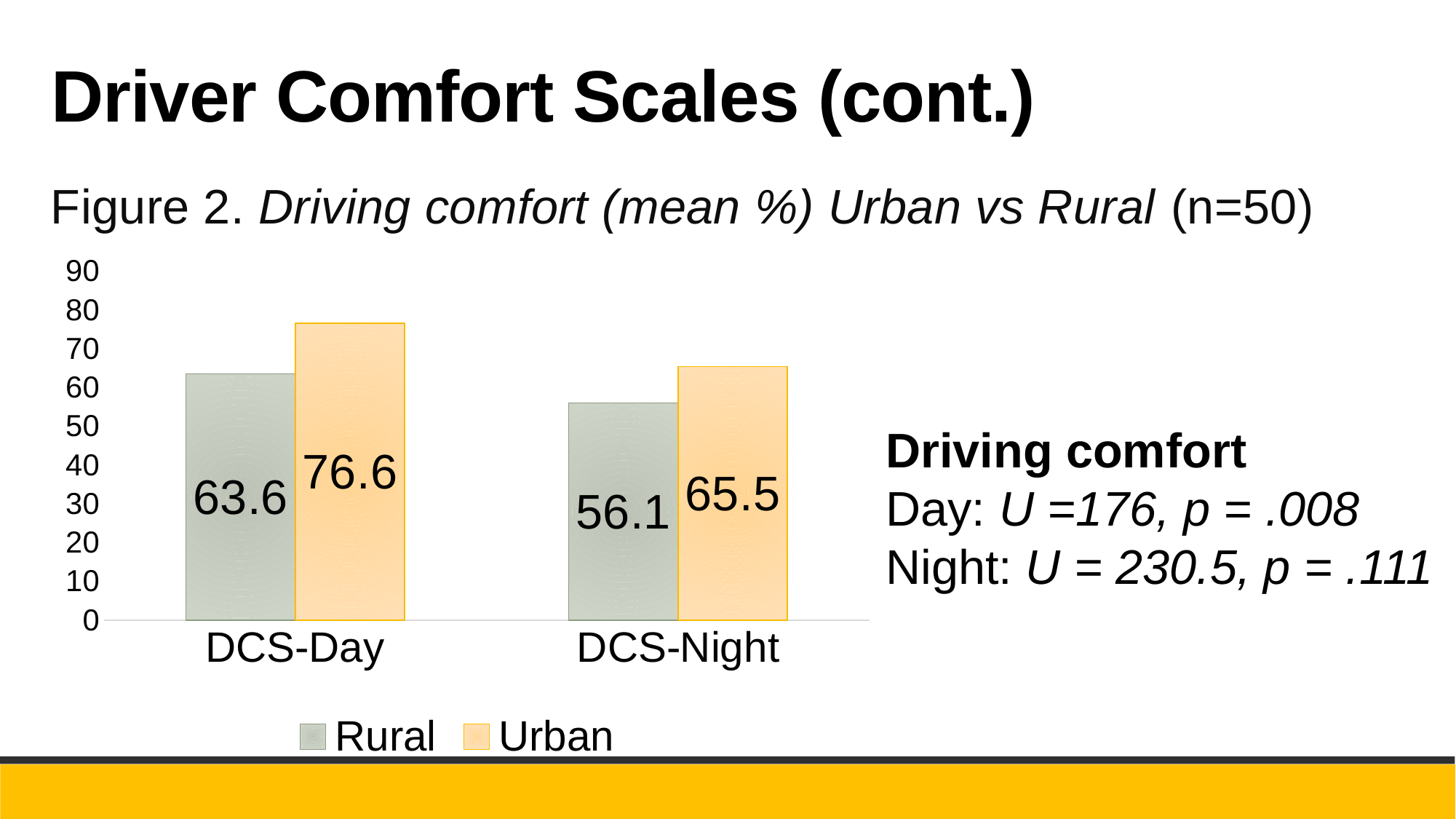
How many series does the legend list? 2 What is the Urban value for DCS-Night? 65.5 What is the Rural value for DCS-Day? 63.6 How many categories are shown on the x axis? 2 What is the Urban value for DCS-Day? 76.6 Which is larger for DCS-Night, the Rural value or the Urban value? Urban What is the difference between the Urban and Rural values for DCS-Night? 9.4 What is the Rural value for DCS-Night? 56.1 Which bar has the highest value in the chart? Urban, DCS-Day Which bar has the lowest value in the chart? Rural, DCS-Night What is the difference between the Urban and Rural values for DCS-Day? 13 What kind of chart is shown on the slide? Bar chart